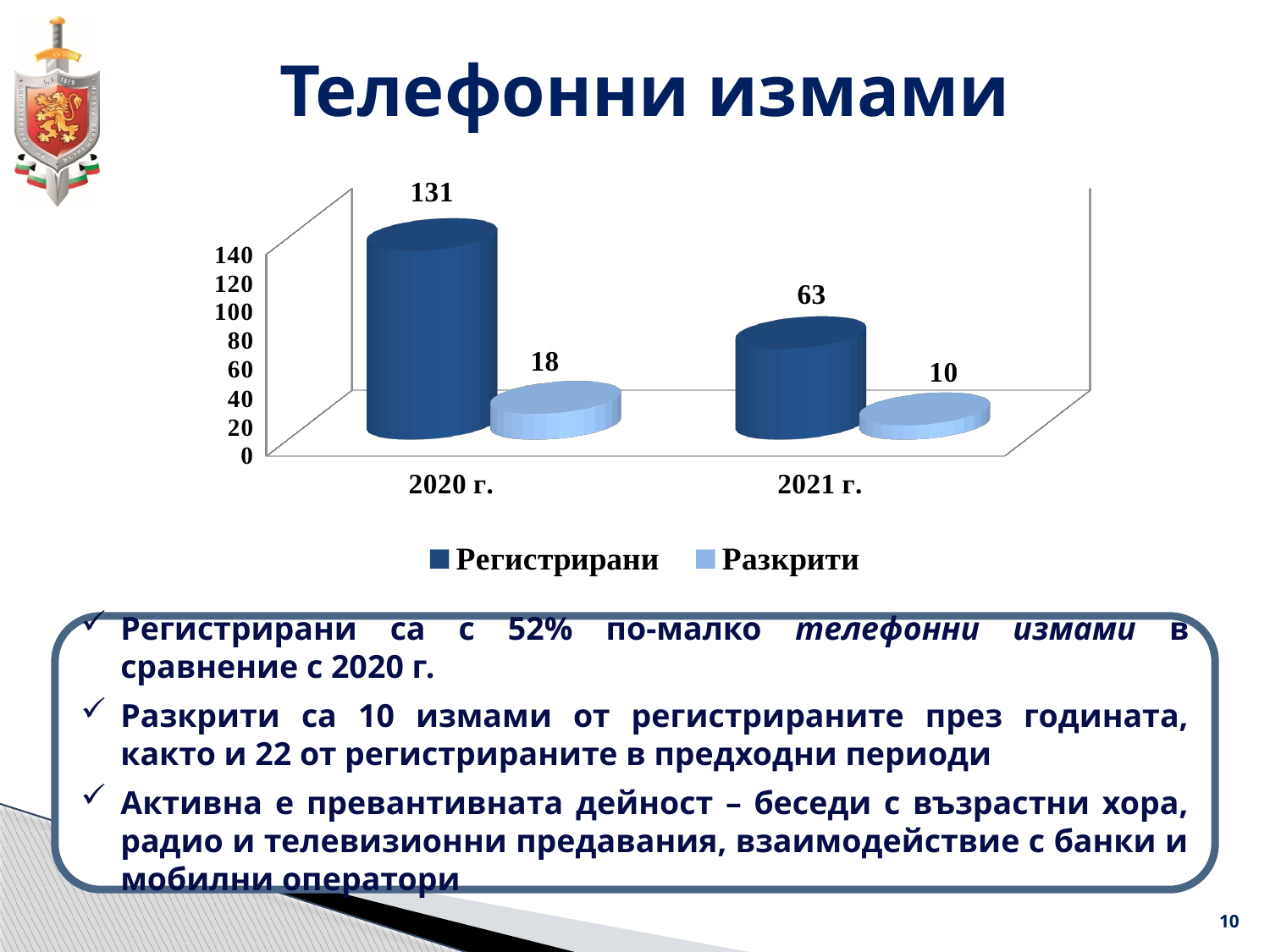
What is the value for Регистрирани in 2021 г.? 63 What is the difference between Регистрирани in 2020 г. and 2021 г.? 68 How many series does the legend list? 2 What is the value for Разкрити in 2020 г.? 18 How many categories are shown on the x axis? 2 Which is larger: Разкрити in 2020 г. or Разкрити in 2021 г.? Разкрити in 2020 г. What is the value for Регистрирани in 2020 г.? 131 Which year has the lowest value for Разкрити? 2021 г. Which year has the highest value for Регистрирани? 2020 г. What kind of chart is shown on the slide? Bar chart Do the values for Регистрирани rise or fall from 2020 г. to 2021 г.? Fall What is the value for Разкрити in 2021 г.? 10